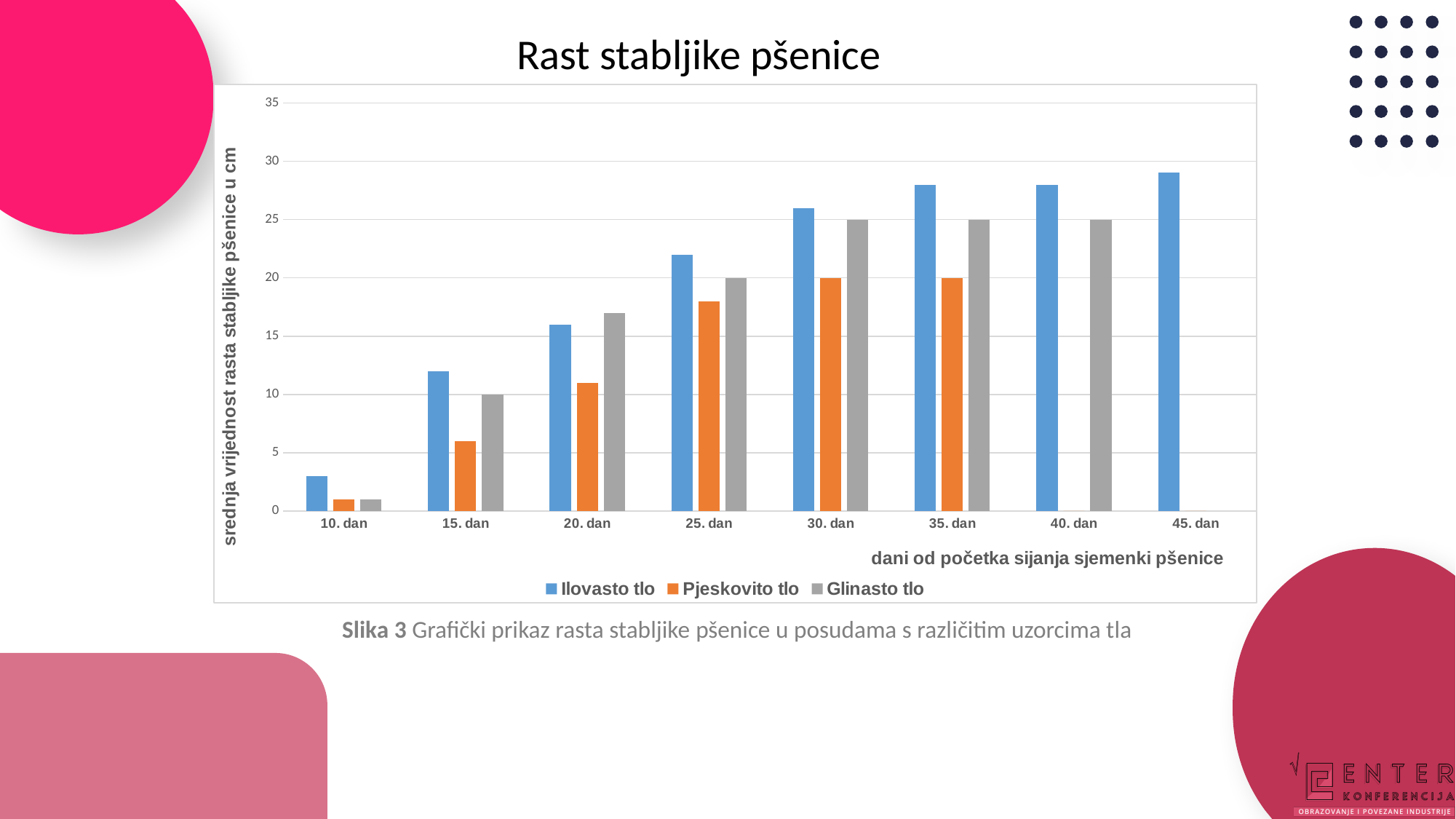
How many series does the legend list? 3 Which series has the highest value at 25. dan? Ilovasto tlo Do the values for Ilovasto tlo rise or fall from 10. dan to 45. dan? rise What kind of chart is shown on the slide? bar chart What is the value for Glinasto tlo at 40. dan? 25 What is the value for Pjeskovito tlo at 30. dan? 20 How many day categories are shown on the x axis? 8 Which is larger at 30. dan: Ilovasto tlo or Glinasto tlo? Ilovasto tlo What is the value for Glinasto tlo at 15. dan? 10 Which series has the lowest value at 20. dan? Pjeskovito tlo Is the value for Ilovasto tlo at 45. dan greater or less than 25? greater Is the value for Pjeskovito tlo at 15. dan greater or less than 10? less